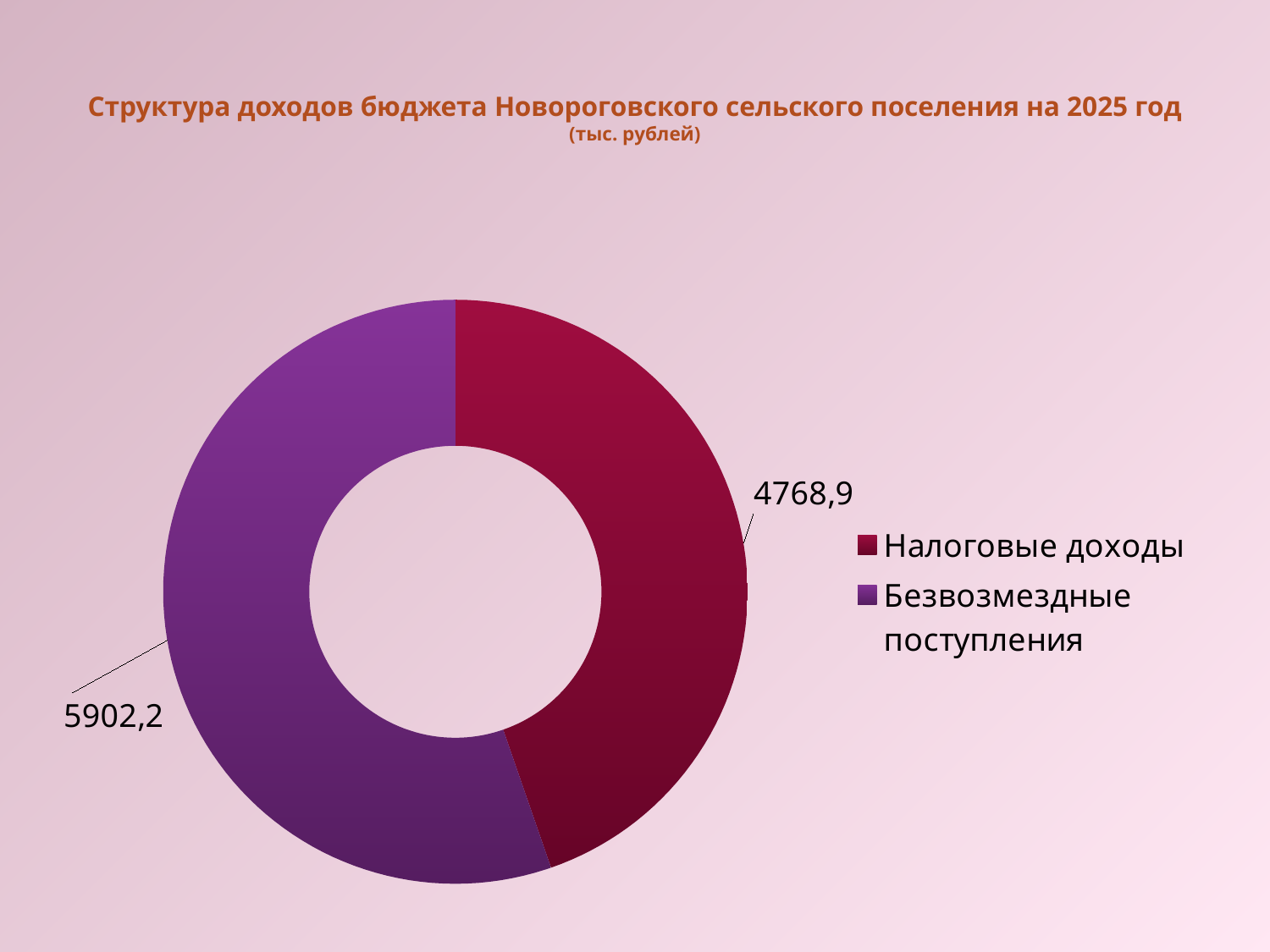
What is the value for Безвозмездные поступления? 5902,2 How many categories are shown in the chart? 2 What is the total of the two values shown in the chart? 10671,1 What share of the total does Безвозмездные поступления represent? 55,3% How many entries does the legend list? 2 What unit is stated under the chart title? тыс. рублей What kind of chart is shown on the slide? Doughnut (pie) chart Which category has the largest value? Безвозмездные поступления What is the difference between Безвозмездные поступления and Налоговые доходы? 1133,3 Which is larger, Налоговые доходы or Безвозмездные поступления? Безвозмездные поступления Which category has the smallest value? Налоговые доходы What is the value for Налоговые доходы? 4768,9